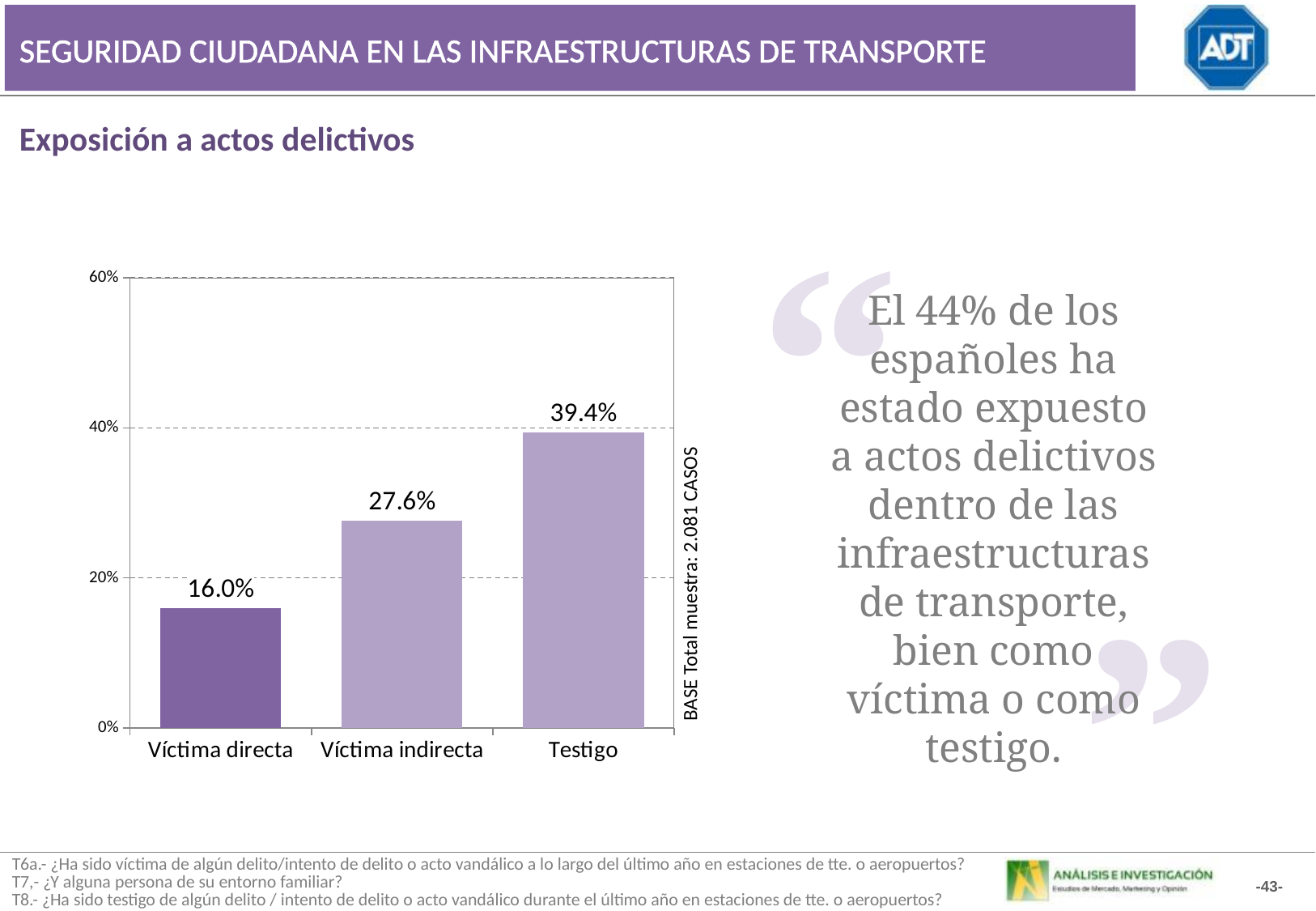
Which category has the lowest value? Víctima directa What kind of chart is shown on the slide? bar chart How many categories are shown on the x axis? 3 What is the value for Víctima directa? 16.0% What is the value for Víctima indirecta? 27.6% What is the difference between the values for Víctima indirecta and Víctima directa? 11.6% Which is larger, the value for Víctima indirecta or the value for Testigo? Testigo Which category has the highest value? Testigo What is the difference between the values for Testigo and Víctima directa? 23.4% Is the value for Testigo greater or less than 40%? less Do the values rise or fall from left to right along the x axis? rise What is the value for Testigo? 39.4%